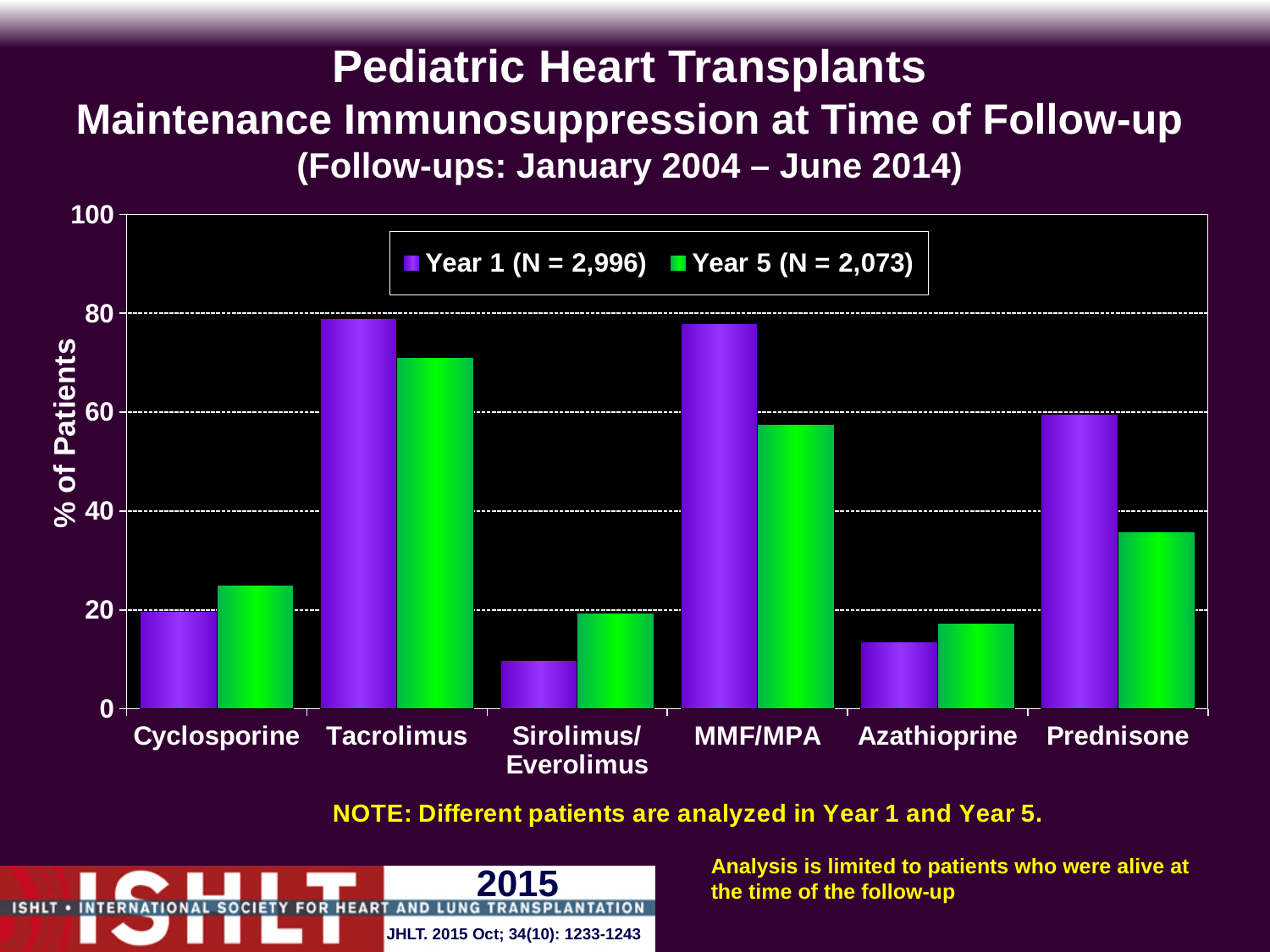
Is the Year 5 value for Prednisone greater or less than 40? less Is the Year 1 value for Sirolimus/Everolimus greater or less than 20? less Is the Year 1 value for Prednisone greater or less than 40? greater How many drug categories are shown on the x axis? 6 What kind of chart is shown on the slide? bar chart For MMF/MPA, which is larger: the Year 1 value or the Year 5 value? Year 1 For Cyclosporine, which is larger: the Year 1 value or the Year 5 value? Year 5 How many series does the legend list? 2 Which drug has the highest Year 5 percentage of patients? Tacrolimus What is the N for the Year 1 series shown in the legend? 2,996 Which drug has the lowest Year 1 percentage of patients? Sirolimus/Everolimus